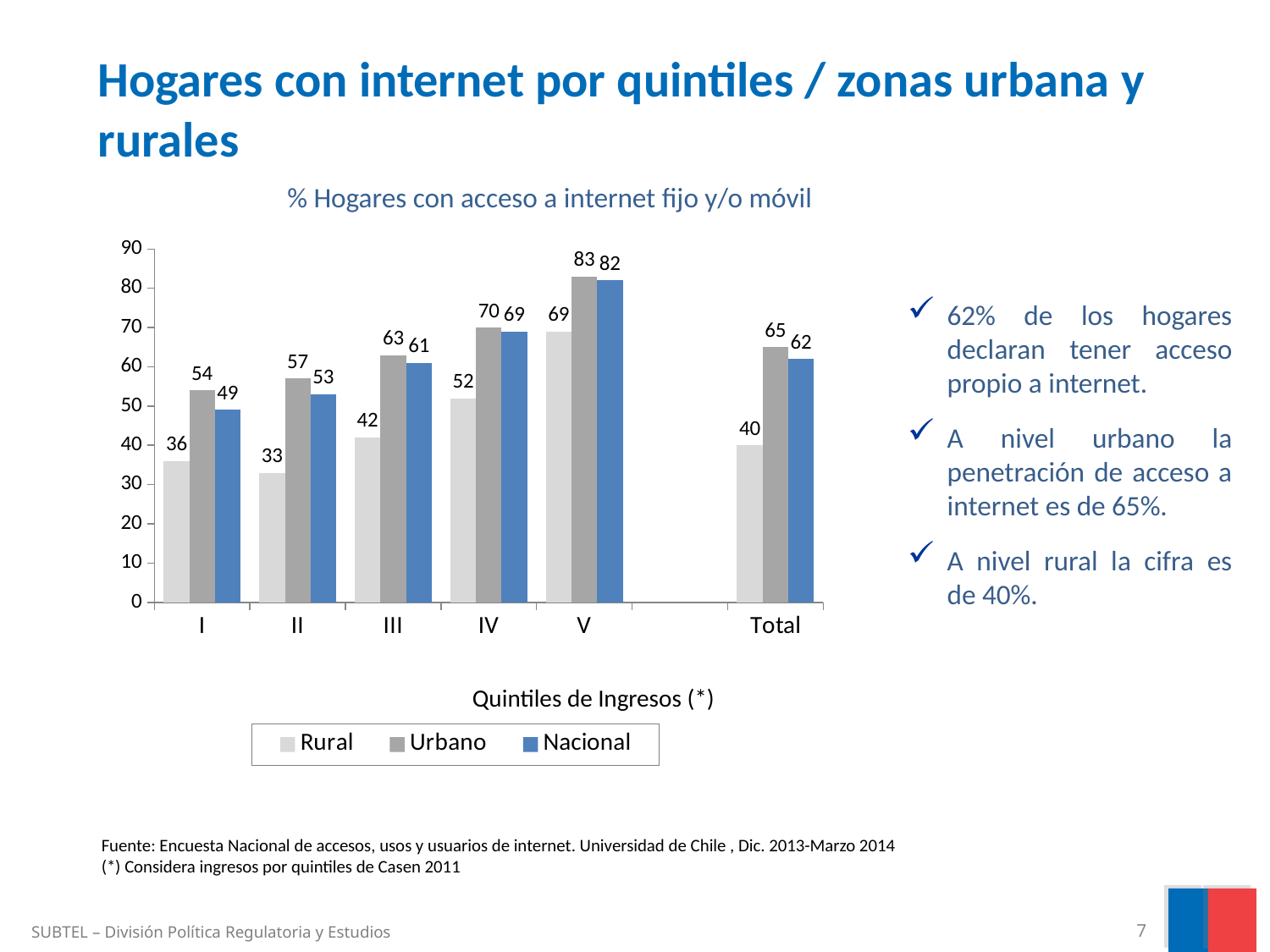
What is the Rural value for quintile I? 36 Which is larger, the Urbano value for quintile III or the Nacional value for quintile III? Urbano How many series does the legend list? 3 Which quintile has the lowest Rural value? II Do the Nacional values rise or fall from quintile I to quintile V? rise How many categories are shown on the x axis? 6 What is the Nacional value for the Total category? 62 What kind of chart is shown? bar chart Which quintile has the highest Nacional value? V What is the title of the chart? % Hogares con acceso a internet fijo y/o móvil What is the Urbano value for quintile V? 83 What is the difference between the Urbano and Rural values for the Total category? 25